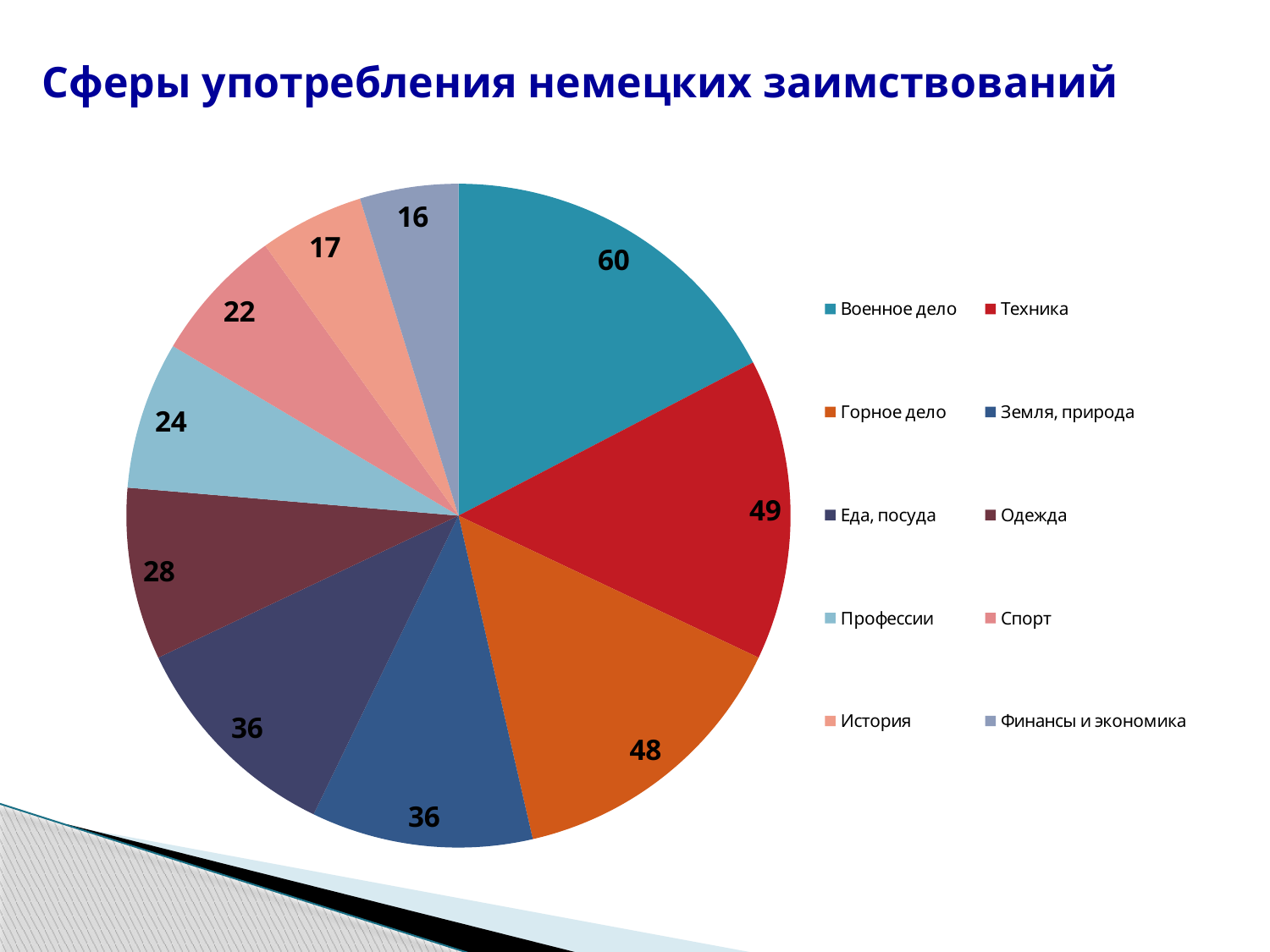
What is the difference between the values for Военное дело and Техника? 11 What type of chart is shown on the slide? Pie chart What is the value for Военное дело? 60 What is the value for Одежда? 28 What is the value for Техника? 49 Which is larger, the value for Одежда or the value for Профессии? Одежда Which category has the smallest slice? Финансы и экономика Which category has the largest slice? Военное дело What is the title of the slide? Сферы употребления немецких заимствований How many categories does the pie chart have? 10 What is the value for История? 17 What is the value for Горное дело? 48